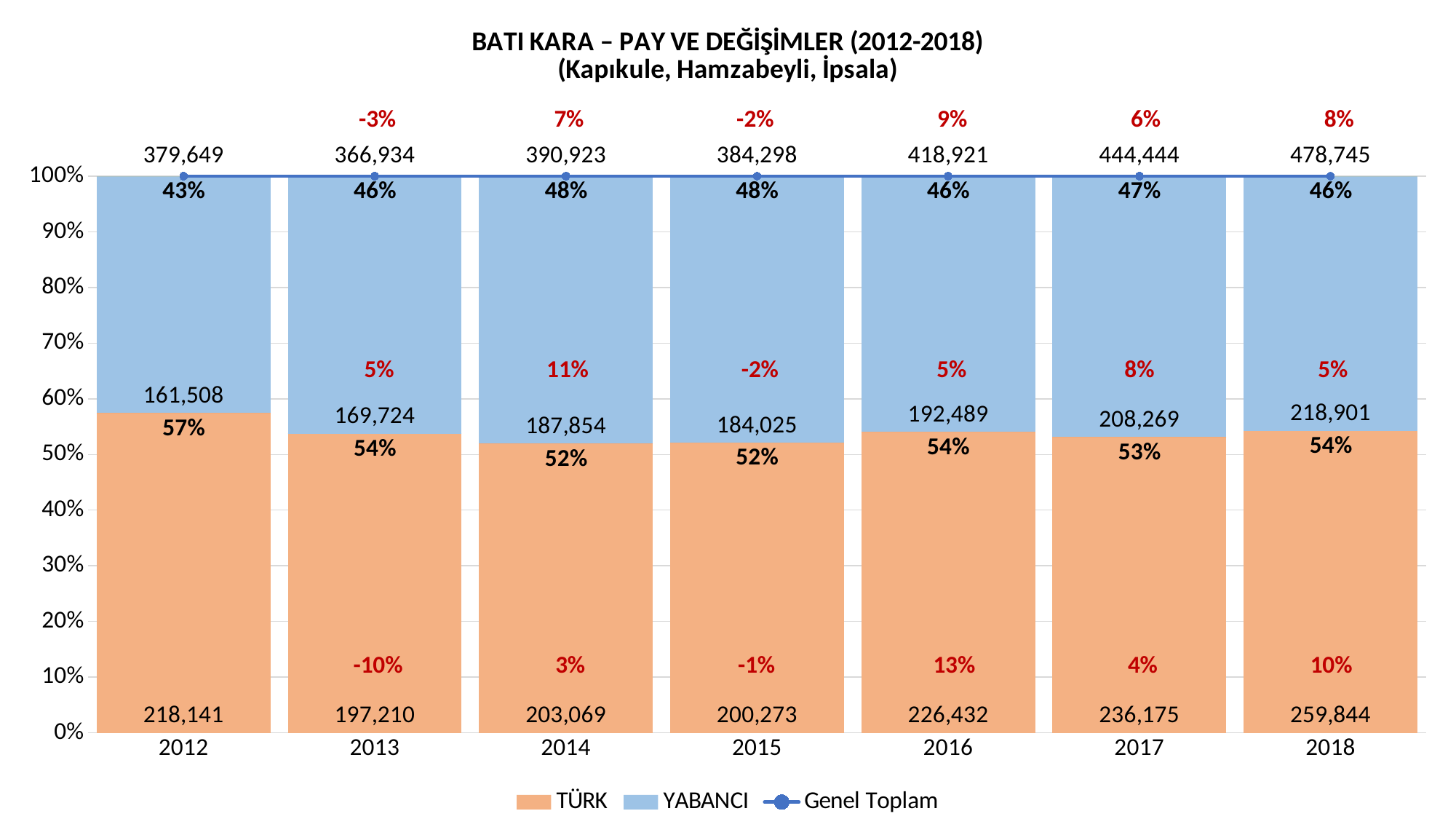
What percentage share does TÜRK have in 2012? 57% What is the difference between the TÜRK values for 2018 and 2017? 23,669 In which year is the TÜRK value lowest? 2013 Does the Genel Toplam value rise or fall from 2015 to 2018? rise How many series does the legend list? 3 What is the Genel Toplam value for 2016? 418,921 Which is larger in 2015, the TÜRK value or the YABANCI value? TÜRK How many years are shown on the x axis? 7 What percentage share does YABANCI have in 2014? 48% What is the YABANCI value for 2018? 218,901 In which year is the Genel Toplam value highest? 2018 What is the TÜRK value for 2012? 218,141